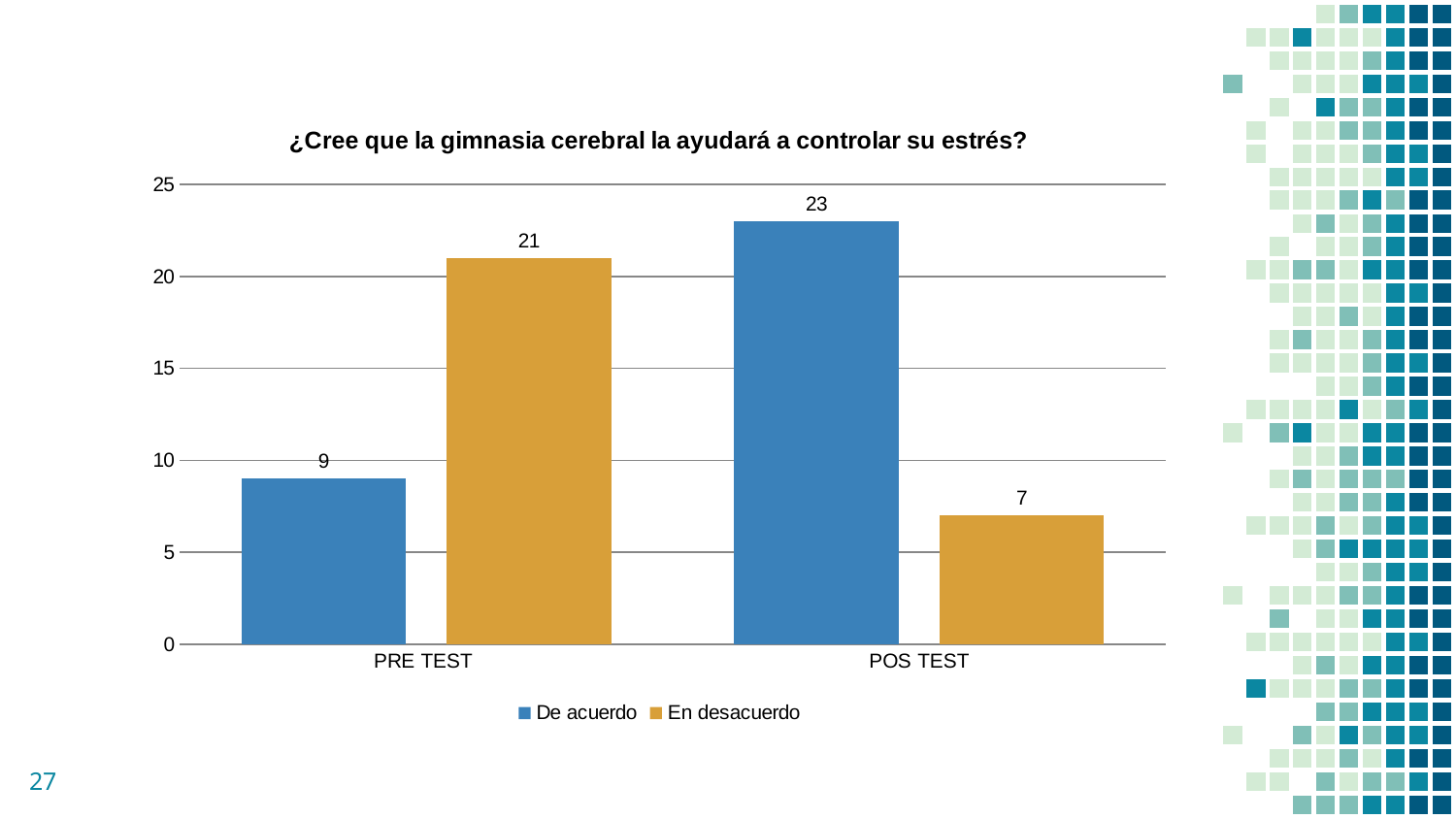
What kind of chart is shown on the slide? Bar chart What is the value for De acuerdo in PRE TEST? 9 What is the value for En desacuerdo in PRE TEST? 21 Which bar has the highest value on the chart? De acuerdo, POS TEST What is the difference between De acuerdo in POS TEST and De acuerdo in PRE TEST? 14 How many categories are shown on the x axis? 2 How many series does the legend list? 2 What is the value for En desacuerdo in POS TEST? 7 Which is larger in PRE TEST, De acuerdo or En desacuerdo? En desacuerdo What is the title of the chart? ¿Cree que la gimnasia cerebral la ayudará a controlar su estrés? Which bar has the lowest value on the chart? En desacuerdo, POS TEST What is the value for De acuerdo in POS TEST? 23